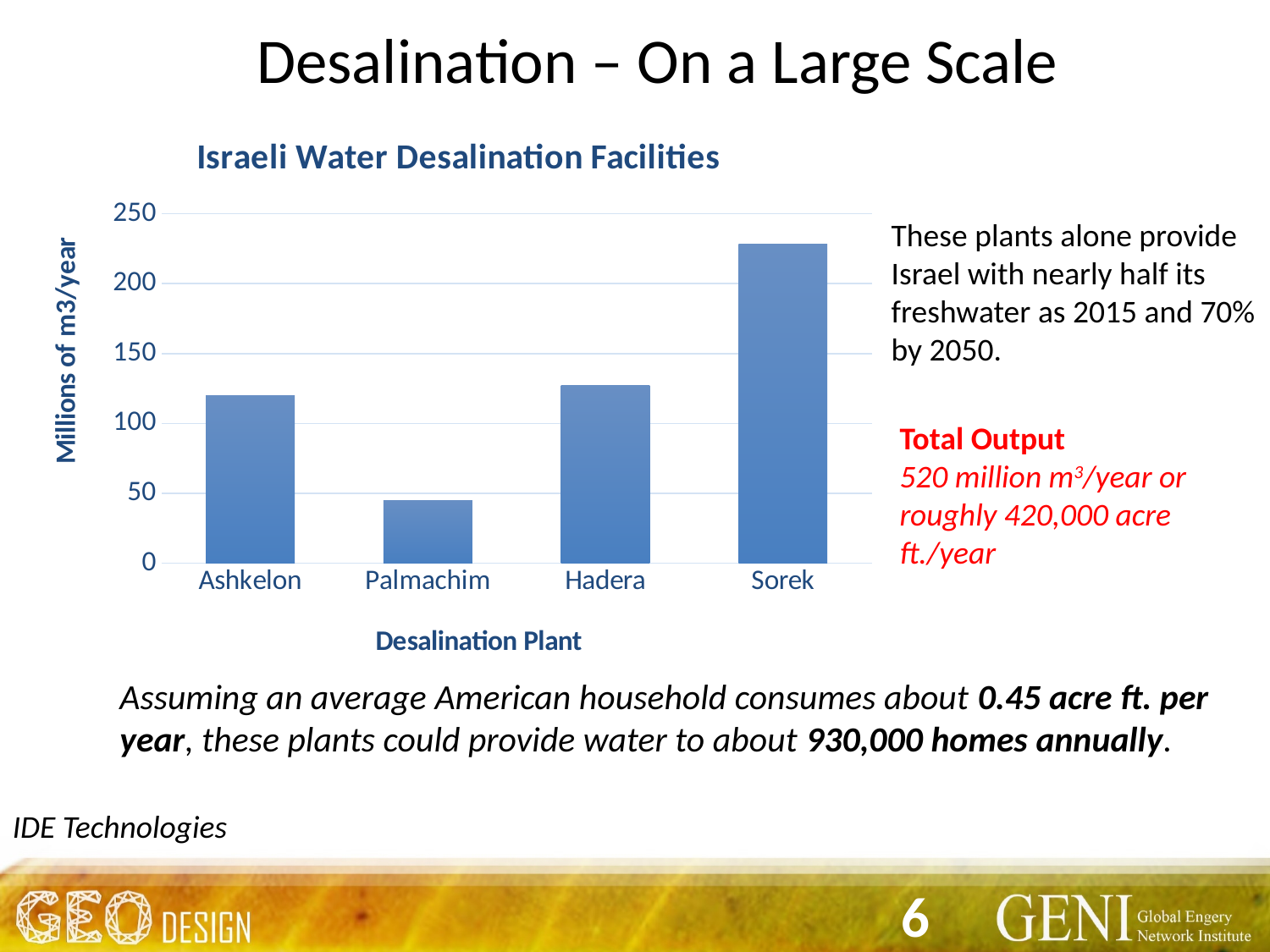
Is the value for Sorek greater or less than 200? greater Which desalination plant has the highest output in the chart? Sorek What kind of chart is shown on the slide? bar chart What is the title of the chart? Israeli Water Desalination Facilities Is the value for Ashkelon greater or less than 100? greater Which has a larger value, Hadera or Palmachim? Hadera Which desalination plant has the lowest output in the chart? Palmachim Which has a larger value, Sorek or Ashkelon? Sorek Is the value for Palmachim greater or less than 50? less What is the label of the chart's vertical axis? Millions of m3/year How many desalination plants are shown on the x axis of the chart? 4